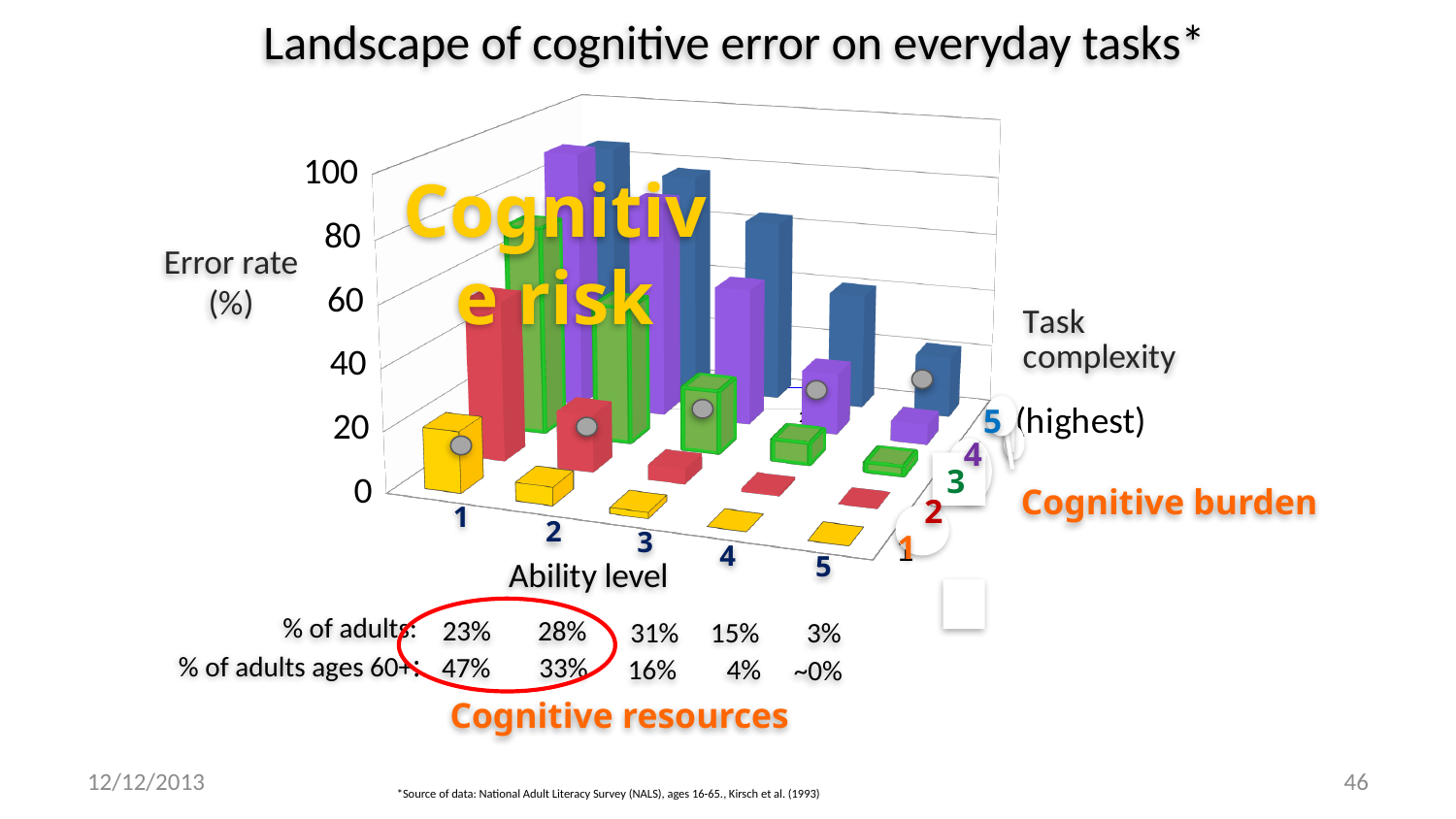
Is the error rate for ability level 5 at task complexity 2 greater or less than 20? less Which is larger: the error rate for ability level 1 at task complexity 5, or for ability level 5 at task complexity 5? ability level 1 at task complexity 5 Is the error rate for ability level 1 at task complexity 4 greater or less than 60? greater What is the title of the chart? Landscape of cognitive error on everyday tasks What kind of chart is shown on the slide? 3D bar chart How many ability levels are shown along the x axis? 5 How many task complexity levels are plotted in the chart? 5 What is the label of the vertical axis? Error rate (%) Is the error rate for ability level 1 at task complexity 5 greater or less than 60? greater For task complexity 5, does the error rate rise or fall as ability level increases from 1 to 5? fall